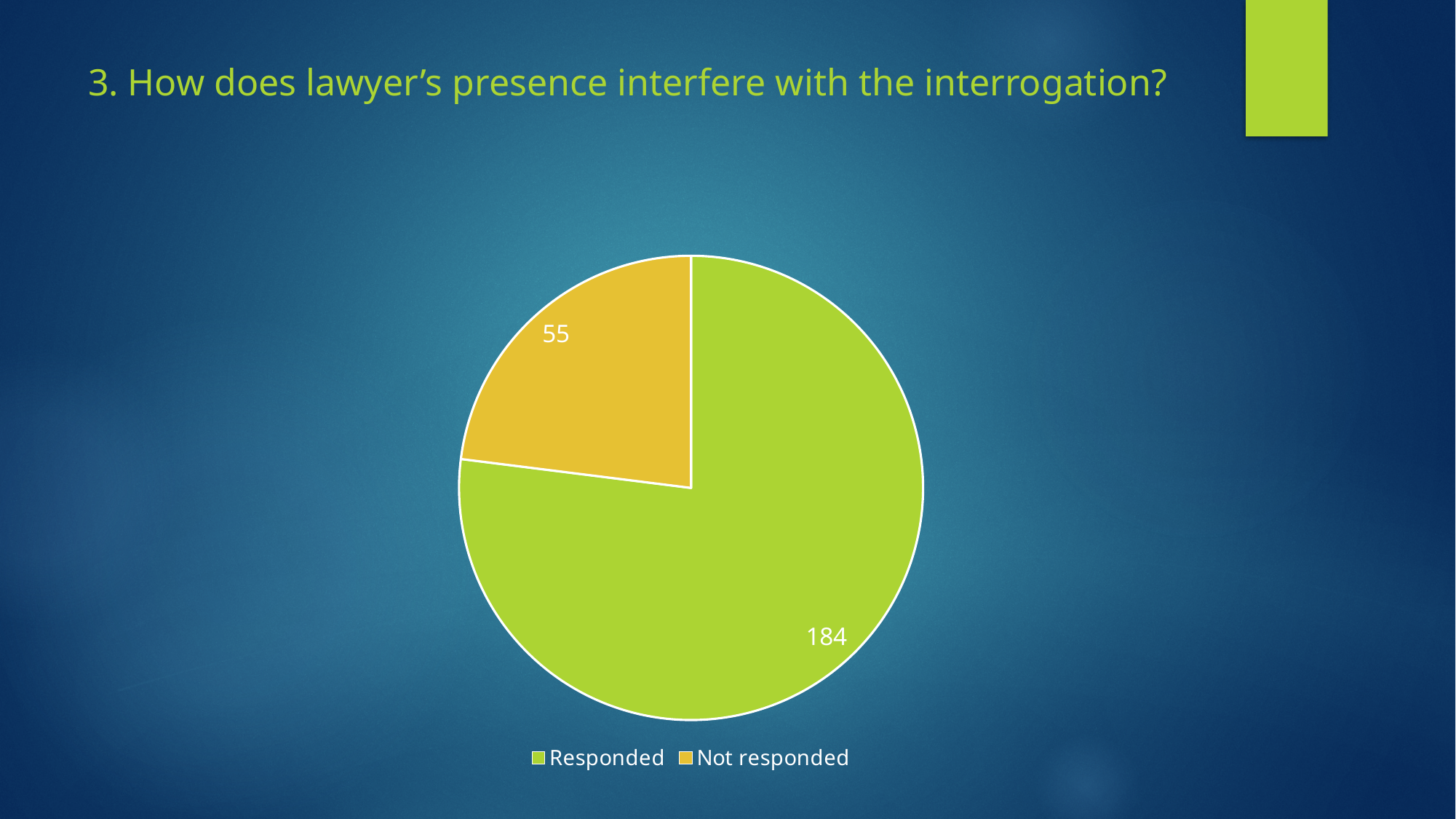
What is the title of the slide containing the chart? 3. How does lawyer’s presence interfere with the interrogation? Which category has the smallest slice? Not responded What is the total of all slices in the pie chart? 239 How many slices does the pie chart have? 2 What is the value for Not responded? 55 What type of chart is shown on the slide? pie chart What is the difference between the Responded and Not responded values? 129 What colour is the Not responded slice? yellow How many entries does the legend list? 2 Which category has the largest slice? Responded What is the value for Responded? 184 Which is larger, Responded or Not responded? Responded